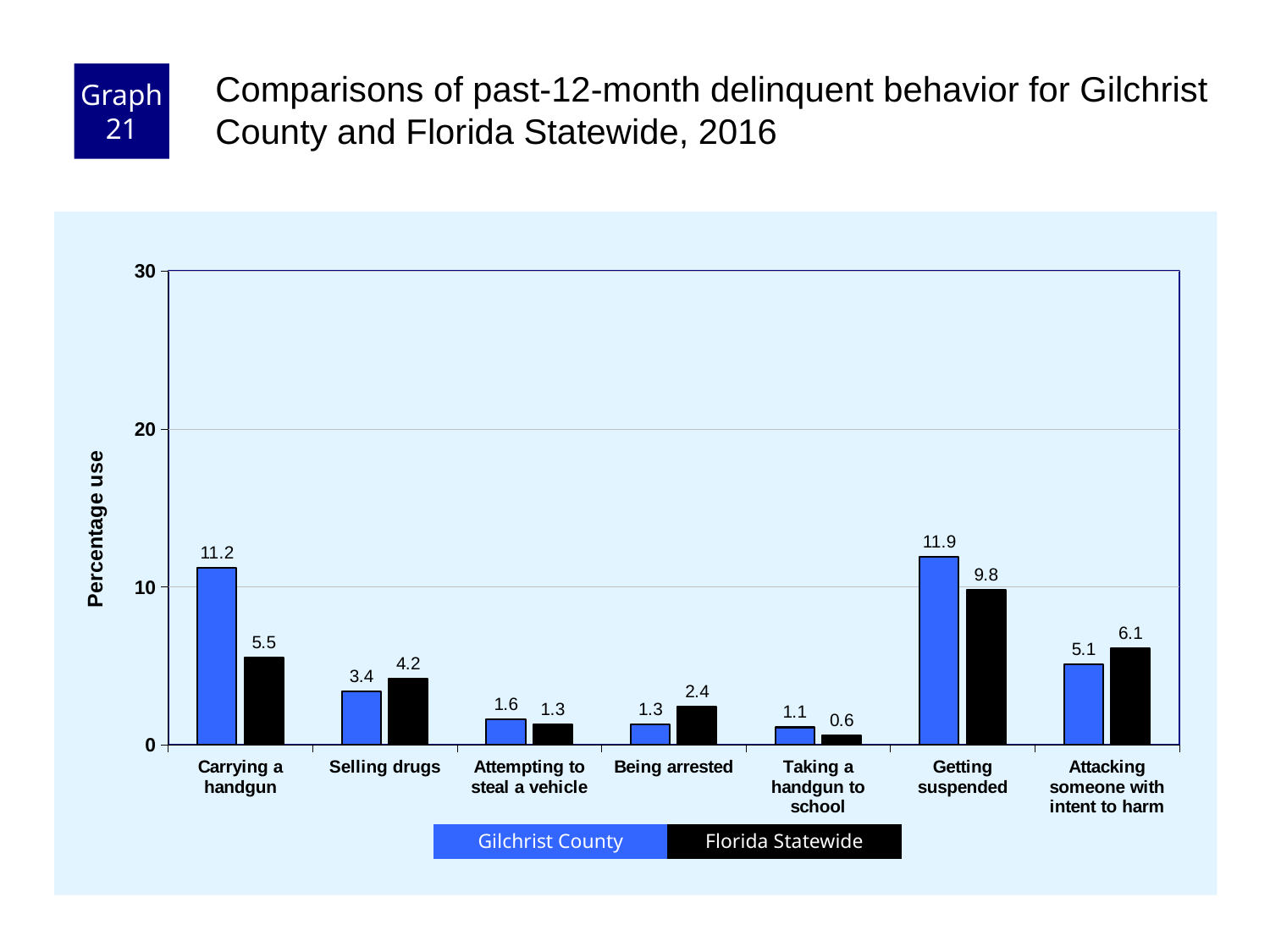
Which category has the highest Gilchrist County value? Getting suspended For Being arrested, which is larger: Gilchrist County or Florida Statewide? Florida Statewide What is the difference between the Gilchrist County and Florida Statewide values for Carrying a handgun? 5.7 Is the Gilchrist County value for Getting suspended greater or less than 10? greater What is the Florida Statewide value for Taking a handgun to school? 0.6 Which category has the lowest Florida Statewide value? Taking a handgun to school What is the Gilchrist County value for Carrying a handgun? 11.2 How many series does the legend list? 2 What is the Florida Statewide value for Getting suspended? 9.8 What is the label of the y axis? Percentage use What kind of chart is shown on the slide? bar chart How many categories are shown on the x axis? 7